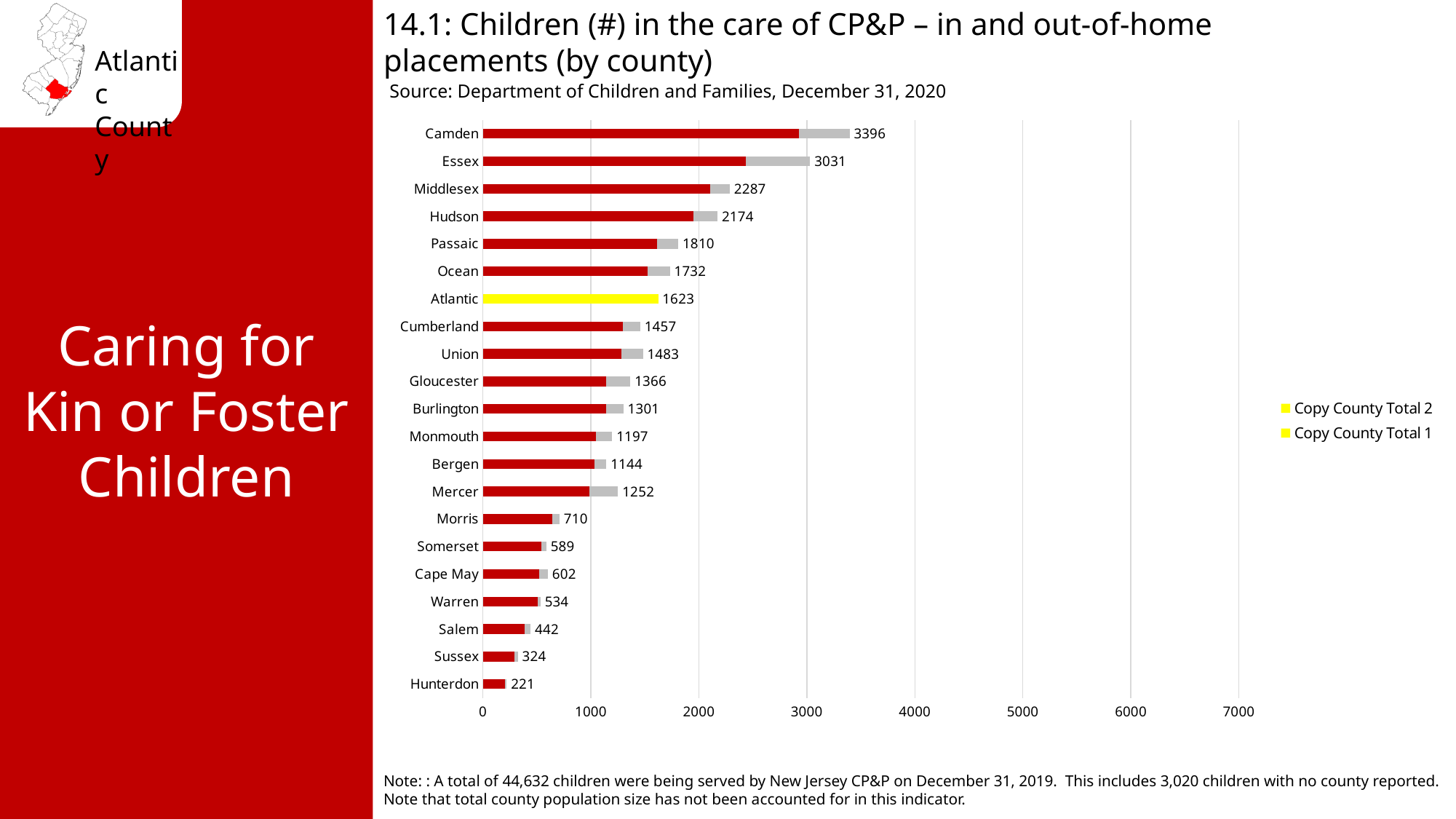
What is the total number of children in the care of CP&P for Atlantic? 1623 What kind of chart is shown on the slide? bar chart What is the difference between the totals for Camden and Essex? 365 How many series does the legend list? 2 What is the total number of children in the care of CP&P for Camden? 3396 Which county's bar is highlighted in yellow? Atlantic Is the total for Passaic greater or less than 2000? less How many counties are shown in the chart? 21 Which county has the highest total number of children in the care of CP&P? Camden What is the total number of children in the care of CP&P for Hunterdon? 221 Which county has a larger total, Union or Cumberland? Union Which county has the lowest total number of children in the care of CP&P? Hunterdon